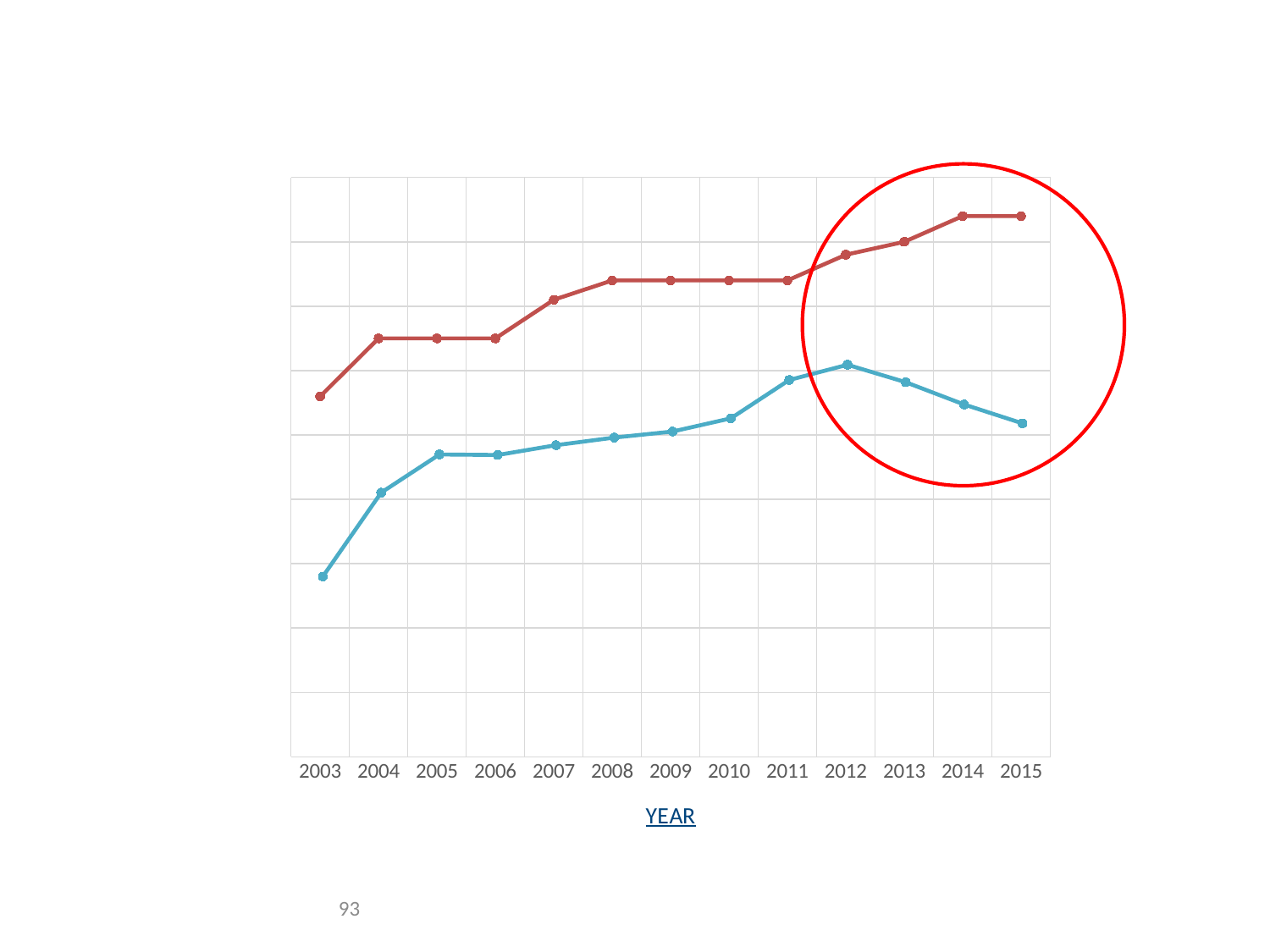
In which year is the red line at its lowest point? 2003 In which year does the blue line reach its highest point? 2012 What kind of chart is shown on the slide? line chart Does the red line rise or fall between 2003 and 2015 overall? rise What is the last year shown on the x axis? 2015 How many years are shown along the x axis of the chart? 13 Does the blue line rise or fall between 2012 and 2015? fall How many lines are plotted on the chart? 2 Which line is higher in 2010, the red line or the blue line? the red line Does the blue line rise or fall between 2003 and 2005? rise In which year is the blue line at its lowest point? 2003 What is the first year shown on the x axis? 2003